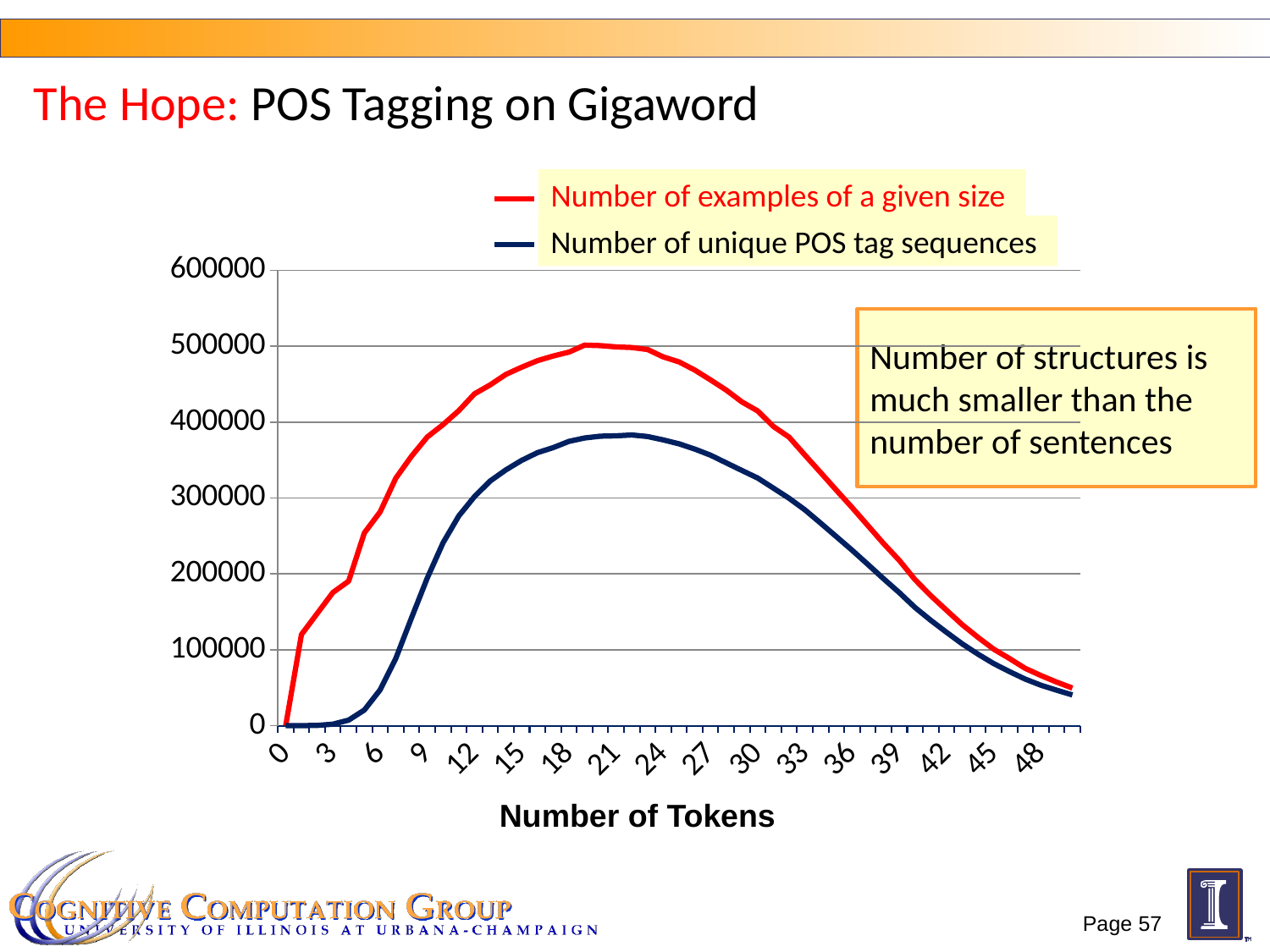
Is the value of 'Number of examples of a given size' at 48 tokens greater or less than 100000? less What kind of chart is shown on the slide? line chart Is the value of 'Number of examples of a given size' at 9 tokens greater or less than 300000? greater How many series does the legend list? 2 At 21 tokens, which series has the larger value: 'Number of examples of a given size' or 'Number of unique POS tag sequences'? Number of examples of a given size Does 'Number of examples of a given size' rise or fall as the number of tokens goes from 24 to 48? fall Is the value of 'Number of unique POS tag sequences' at 3 tokens greater or less than 100000? less What is the title of the x axis? Number of Tokens Which series is drawn in red according to the legend? Number of examples of a given size Which series reaches the higher peak value? Number of examples of a given size